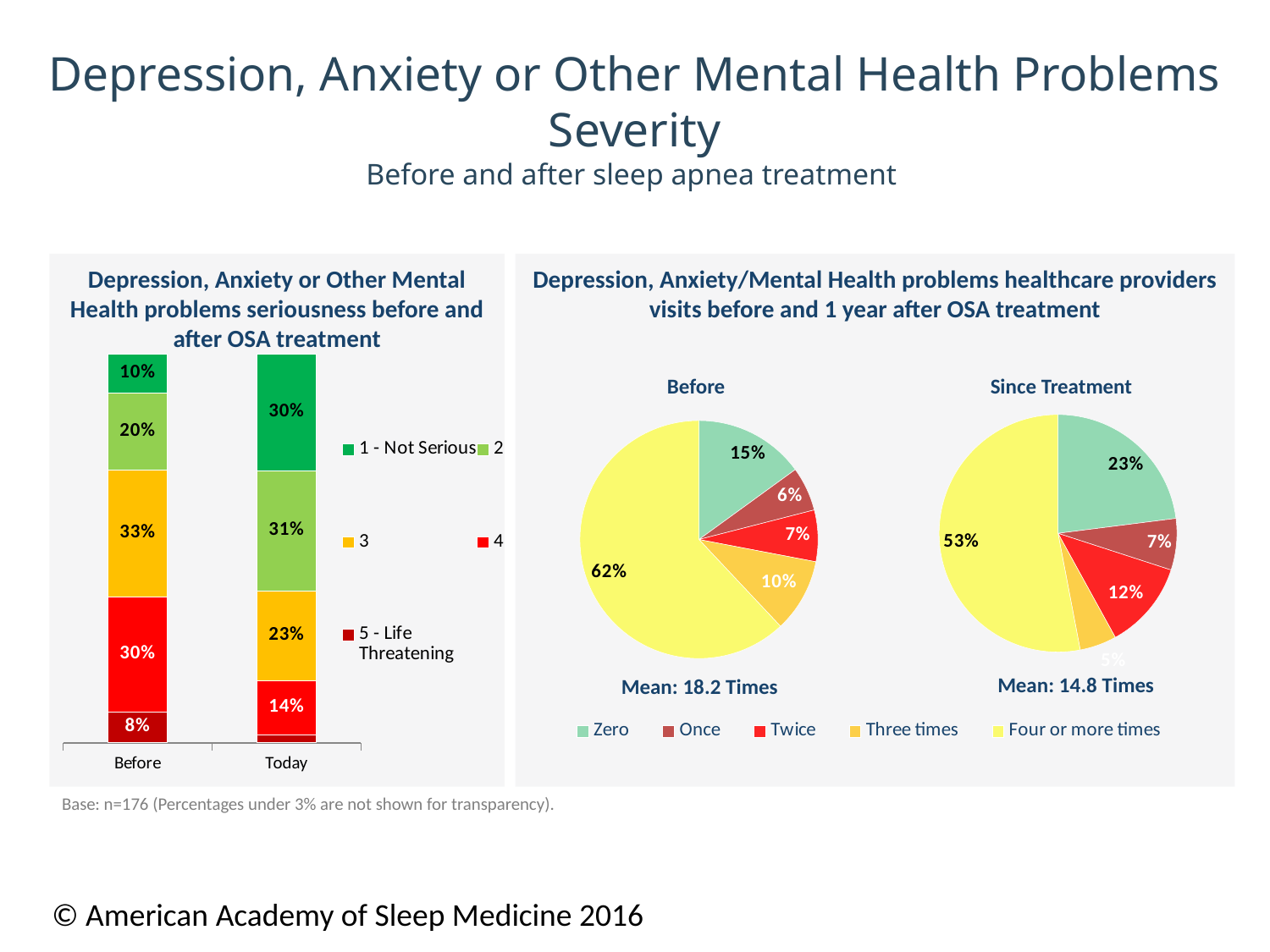
What is the mean number of visits shown under the 'Since Treatment' pie chart? 14.8 Times In the stacked bar chart on the left, what percentage of the 'Before' bar is rated '5 - Life Threatening'? 8% What kind of chart is the chart on the left of the slide? Stacked bar chart In the 'Since Treatment' pie chart, which category has the largest slice? Four or more times How many series does the legend of the stacked bar chart on the left list? 5 In the stacked bar chart on the left, what percentage of the 'Today' bar is rated '1 - Not Serious'? 30% In the 'Since Treatment' pie chart, what share of respondents had zero healthcare provider visits? 23% In the stacked bar chart on the left, which is larger: the '2' segment for Before or the '2' segment for Today? Today In the 'Before' pie chart, what share of respondents had four or more healthcare provider visits? 62% In the stacked bar chart on the left, what percentage of the 'Before' bar is rated 3? 33% In the stacked bar chart on the left, what is the difference between the '4' segment for Before and the '4' segment for Today? 16% In the 'Before' pie chart, which category has the smallest slice? Once